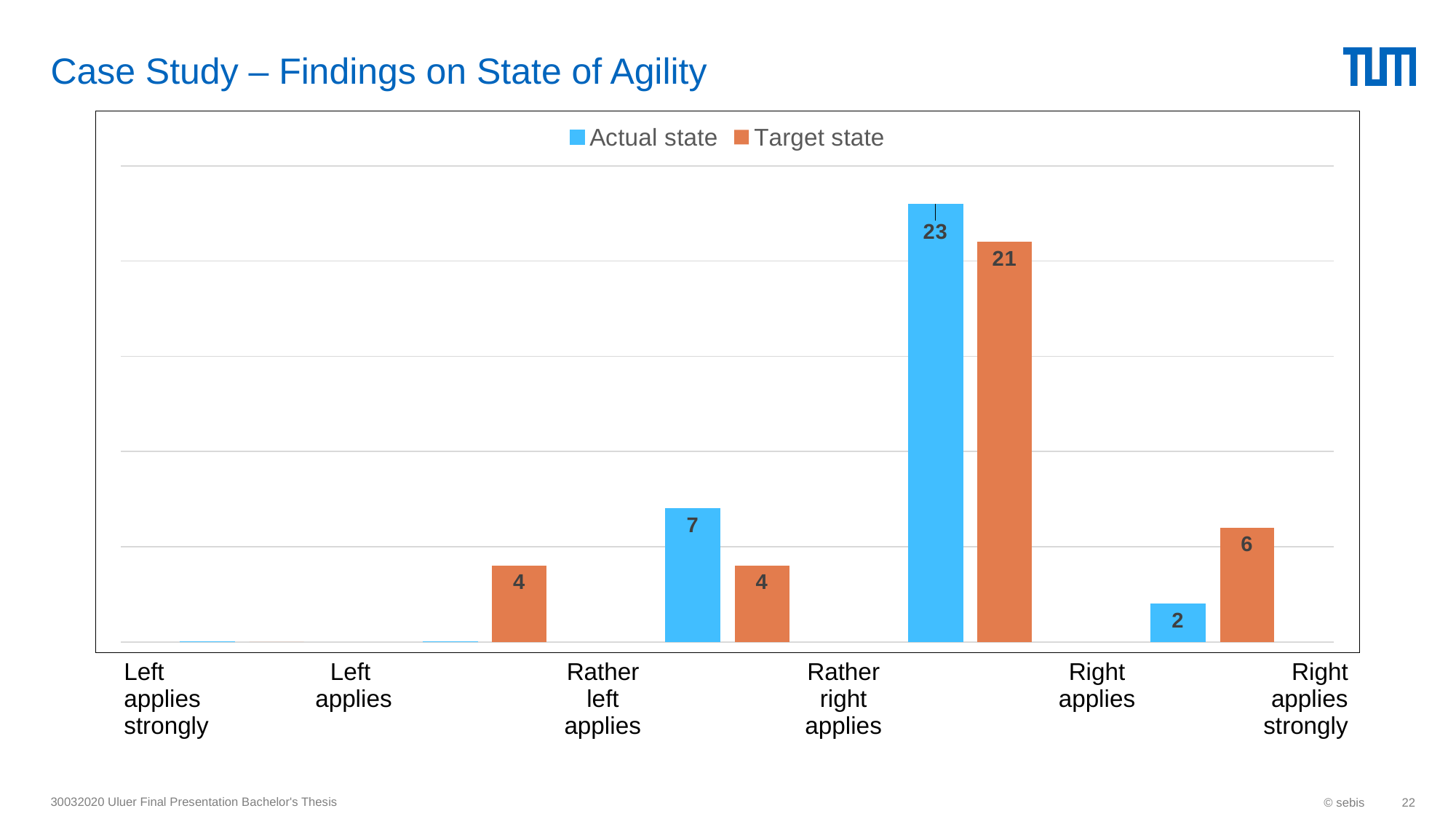
What kind of chart is shown on the slide? Bar chart In the group where the Actual state bar is 7, which series has the larger value, Actual state or Target state? Actual state In the group where the Target state bar is 6, which series has the larger value, Actual state or Target state? Target state Which colour represents the Target state series? Orange In the group where the Target state bar is 6, what is the Actual state value? 2 What is the smallest labelled value for the Actual state series? 2 What is the highest value shown for the Target state series? 21 How many series does the legend list? 2 In the group where the Actual state bar is 7, what is the Target state value? 4 What is the difference between the tallest Actual state bar and the tallest Target state bar? 2 What is the title of the slide containing the chart? Case Study – Findings on State of Agility What is the highest value shown for the Actual state series? 23